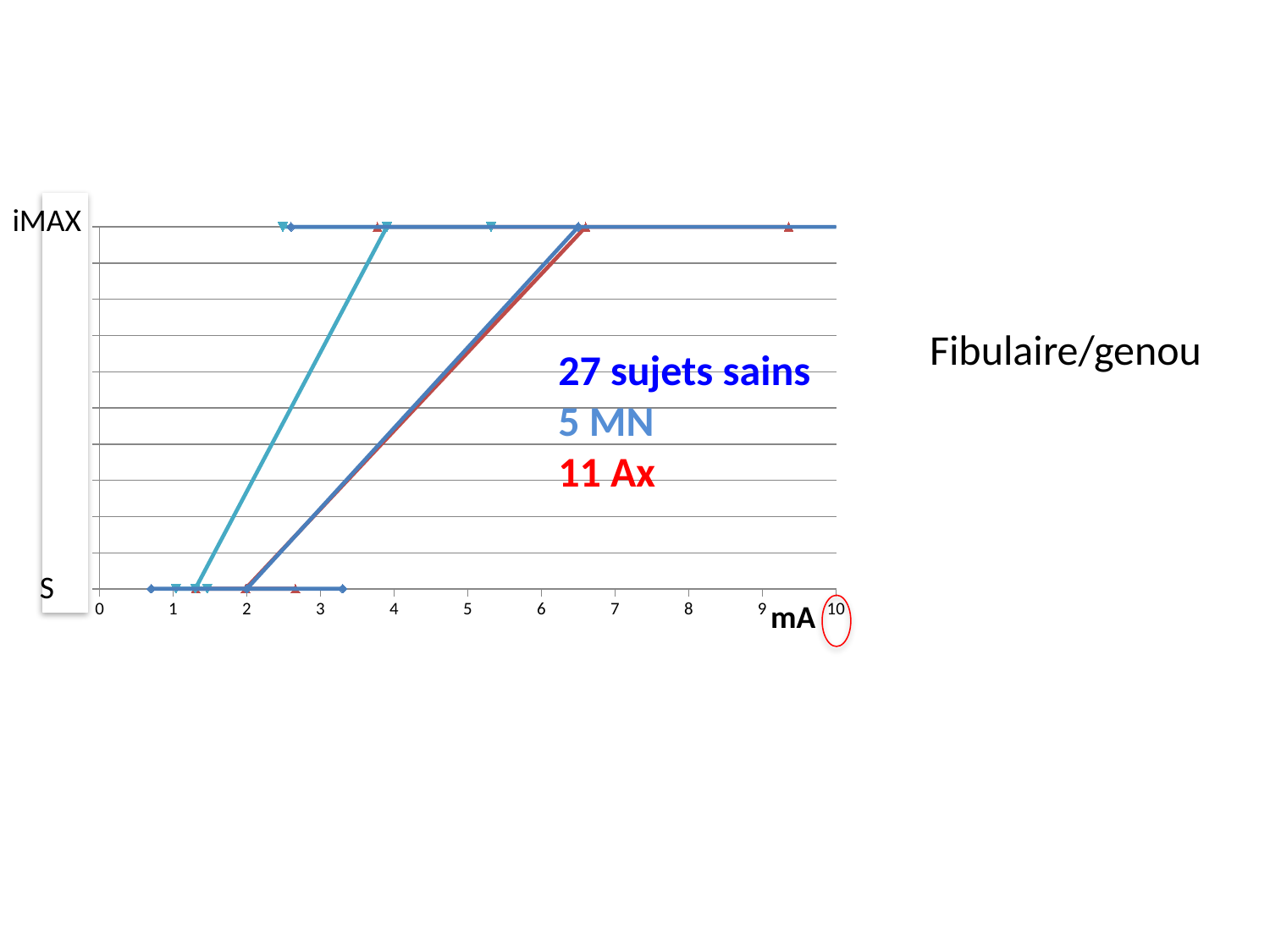
Is the current at which the 11 Ax line reaches iMAX greater or less than 5 mA? greater Which group's line reaches iMAX at the lowest current? 5 MN Is the current at which the 27 sujets sains line reaches iMAX greater or less than 5 mA? greater How many labelled tick values are shown on the x axis of the chart? 11 Do the lines rise or fall as the current (mA) increases along the x axis? rise Is the current at which the 5 MN line leaves the S level greater or less than 2 mA? less What unit is shown on the x axis of the chart? mA What kind of chart is shown on the slide? line chart Which reaches iMAX at a lower current, the 5 MN line or the 27 sujets sains line? 5 MN How many groups (series) are listed in the chart's legend text? 3 What is the highest value shown on the x axis of the chart? 10